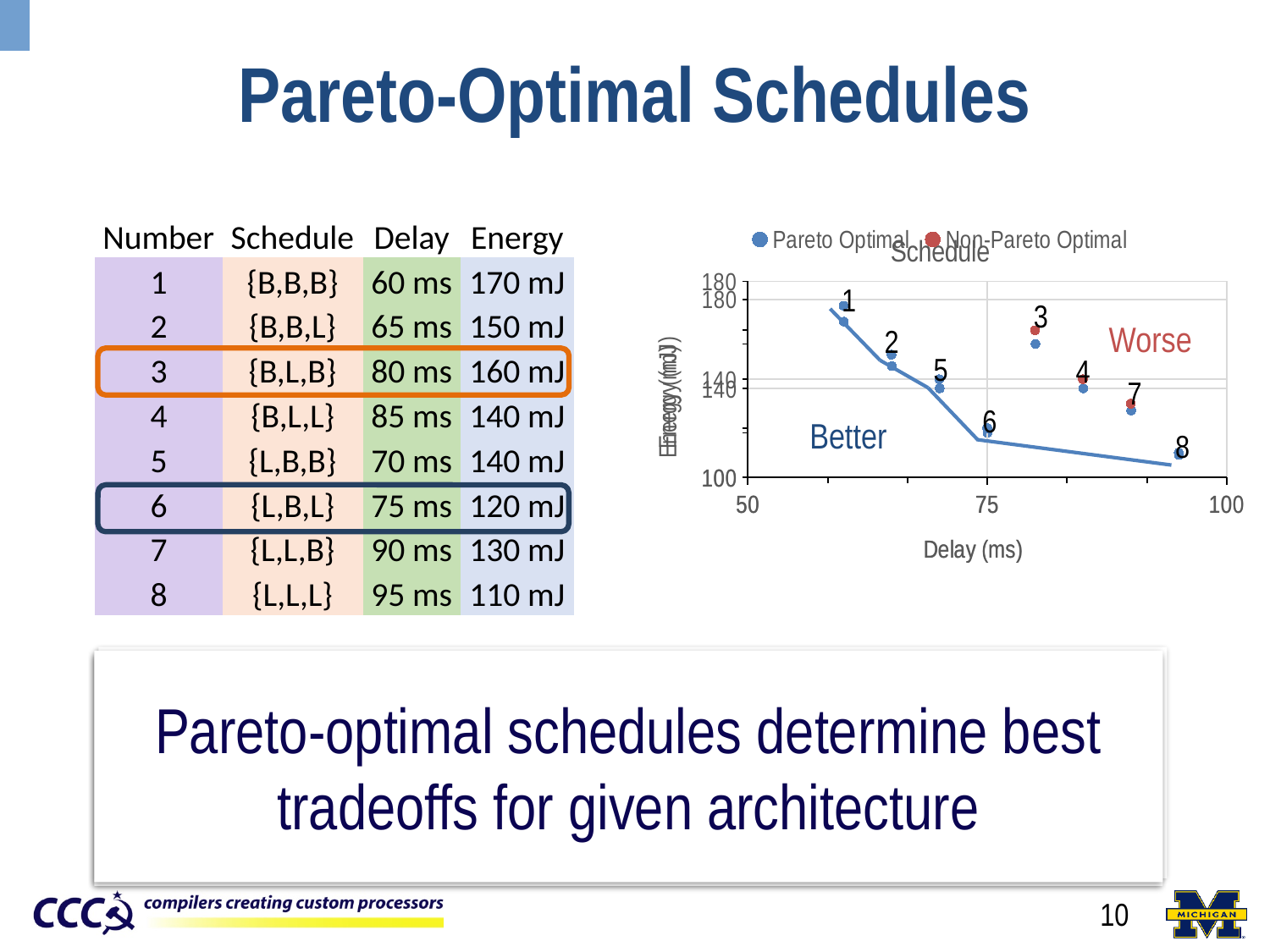
How many series does the chart legend list? 2 Which numbered point has the lowest energy on the chart? 8 How many numbered schedule points are plotted on the chart? 8 Which numbered point has the highest energy on the chart? 1 What kind of chart is shown on the slide? scatter chart Is the delay value for point 3 greater or less than 75? greater Is the energy value for point 1 greater or less than 140? greater What is the title of the chart's x axis? Delay (ms) What are the two entries in the chart legend? Pareto Optimal, Non-Pareto Optimal Is the energy value for point 6 greater or less than 140? less Which has the higher energy, point 3 or point 6? point 3